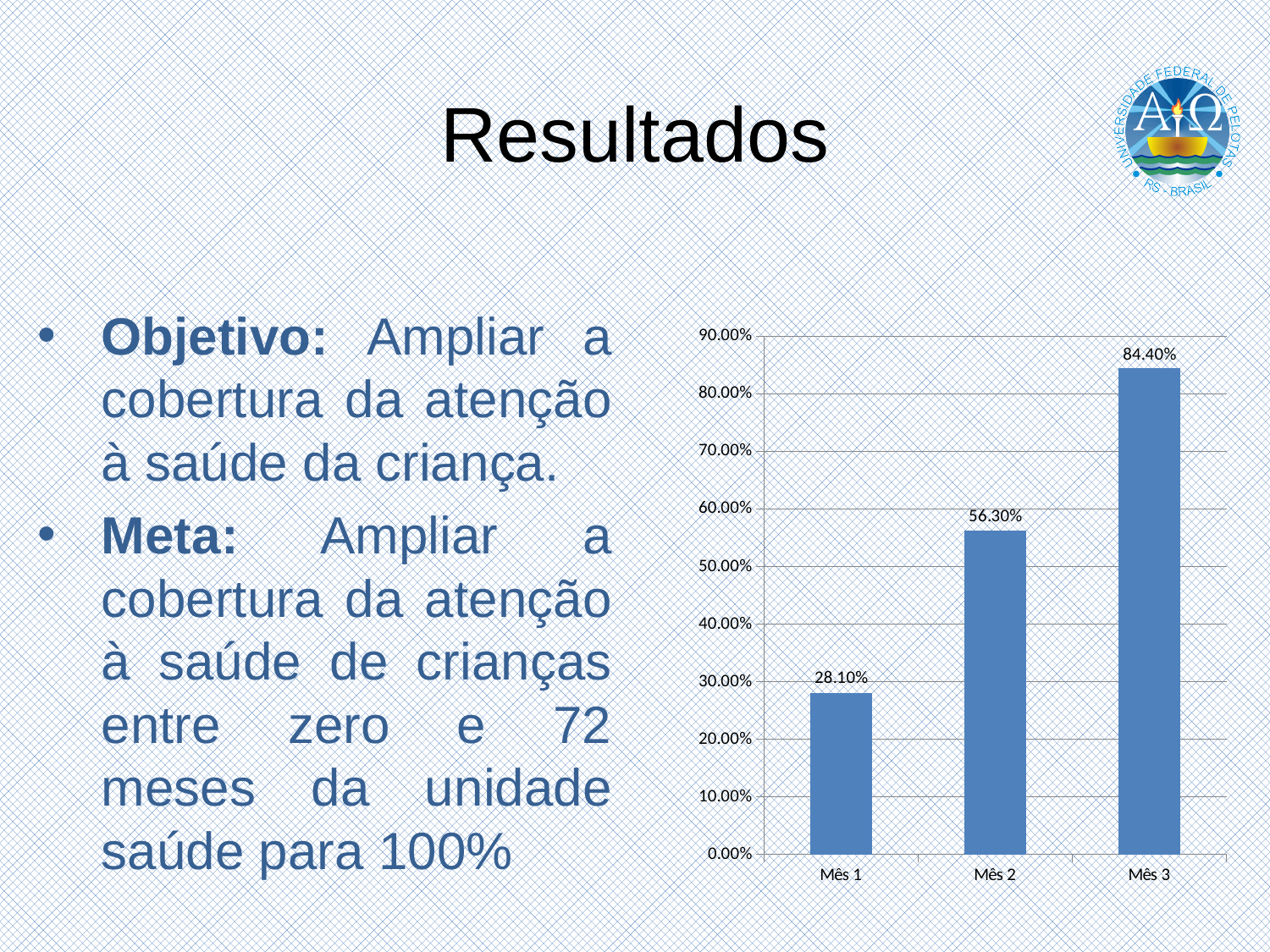
What is the value for Mês 2? 56.30% What kind of chart is shown on the slide? bar chart Which month has the highest value? Mês 3 How many categories are shown on the x axis? 3 What is the difference between the values for Mês 3 and Mês 1? 56.30% What is the value for Mês 1? 28.10% Is the value for Mês 2 greater or less than 50.00%? greater What is the difference between the values for Mês 2 and Mês 1? 28.20% Which is larger, the value for Mês 2 or the value for Mês 3? Mês 3 Which month has the lowest value? Mês 1 Do the values rise or fall from Mês 1 to Mês 3? rise What is the value for Mês 3? 84.40%